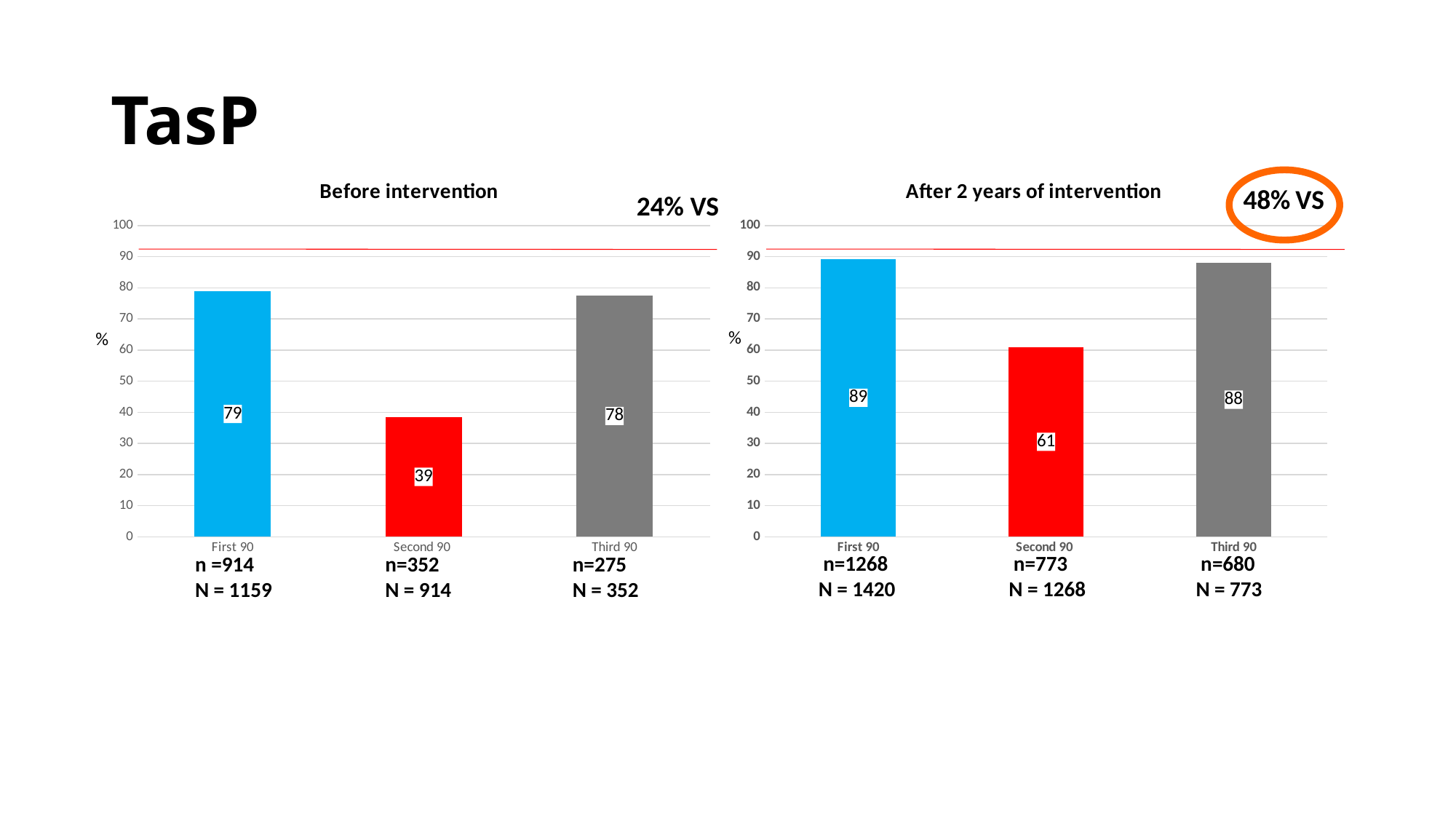
In the 'After 2 years of intervention' chart, which category has the lowest value? Second 90 In the 'Before intervention' chart, what colour is the Second 90 bar? red In the 'After 2 years of intervention' chart, what is the difference between the values for First 90 and Second 90? 28 In the 'Before intervention' chart, what is the value for Second 90? 39 In the 'Before intervention' chart, which category has the lowest value? Second 90 What kind of chart is the 'Before intervention' chart? bar chart How many categories are shown in the 'After 2 years of intervention' chart? 3 In the 'Before intervention' chart, what is the difference between the values for First 90 and Second 90? 40 In the 'Before intervention' chart, is the value for Third 90 greater or less than 70? greater In the 'After 2 years of intervention' chart, what is the value for Third 90? 88 In the 'After 2 years of intervention' chart, what is the value for First 90? 89 Which is larger: the Second 90 value in the 'Before intervention' chart or the Second 90 value in the 'After 2 years of intervention' chart? After 2 years of intervention